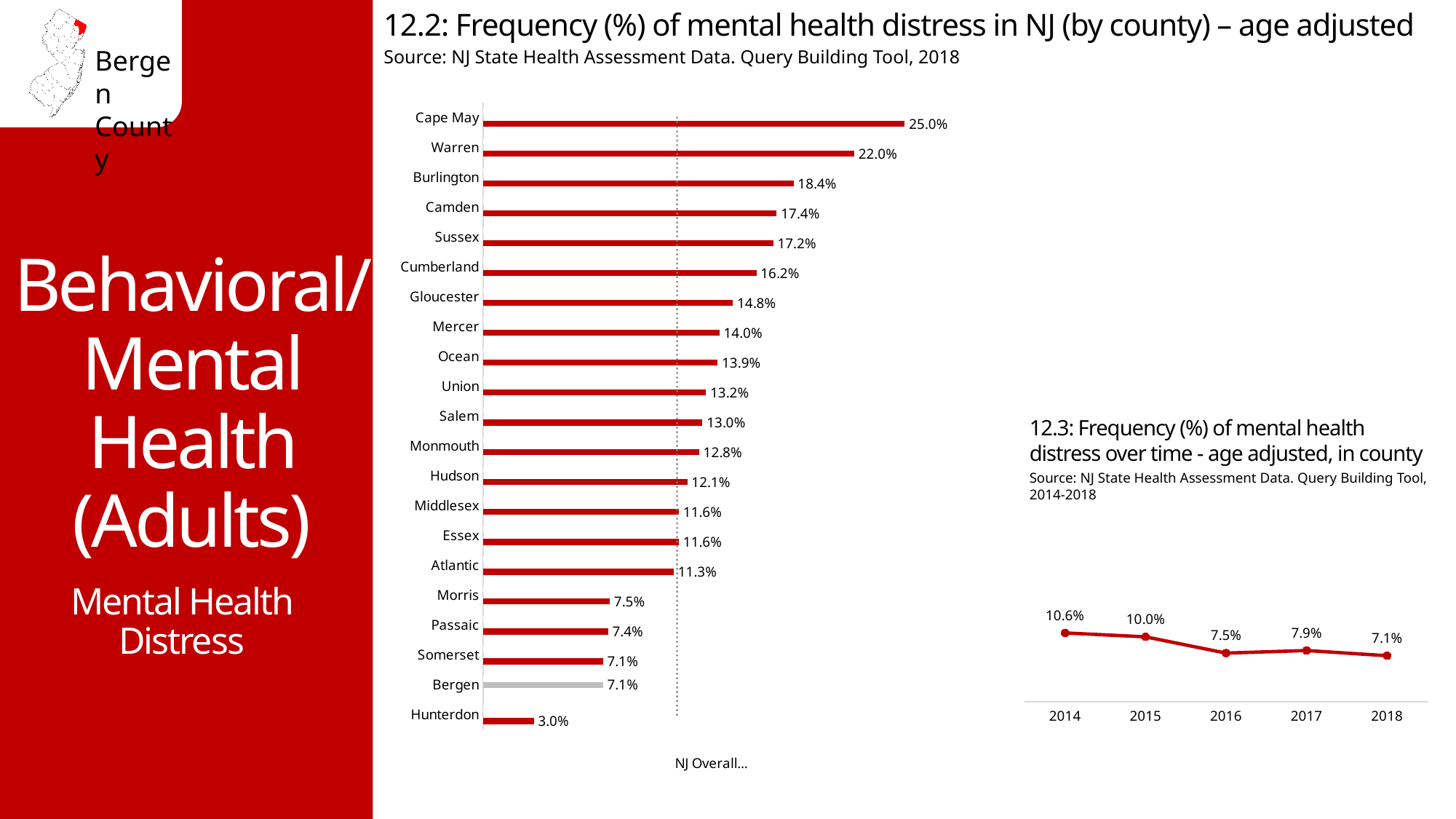
In chart 12.3 (mental health distress over time), what is the difference between 2014 and 2018? 3.5% In chart 12.2 (mental health distress by county), which county has the lowest value? Hunterdon In chart 12.2 (mental health distress by county), what is the value for Gloucester? 14.8% In chart 12.3 (mental health distress over time), what is the value for 2016? 7.5% In chart 12.2 (mental health distress by county), which is larger, the value for Camden or the value for Sussex? Camden What kind of chart is chart 12.2 (mental health distress by county)? Bar chart In chart 12.2 (mental health distress by county), what is the value for Bergen? 7.1% In chart 12.2 (mental health distress by county), how many counties are plotted? 21 In chart 12.3 (mental health distress over time), which year has the highest value? 2014 In chart 12.2 (mental health distress by county), which county has the highest value? Cape May In chart 12.2 (mental health distress by county), what is the difference between Cape May and Warren? 3.0% In chart 12.3 (mental health distress over time), how many years are plotted? 5